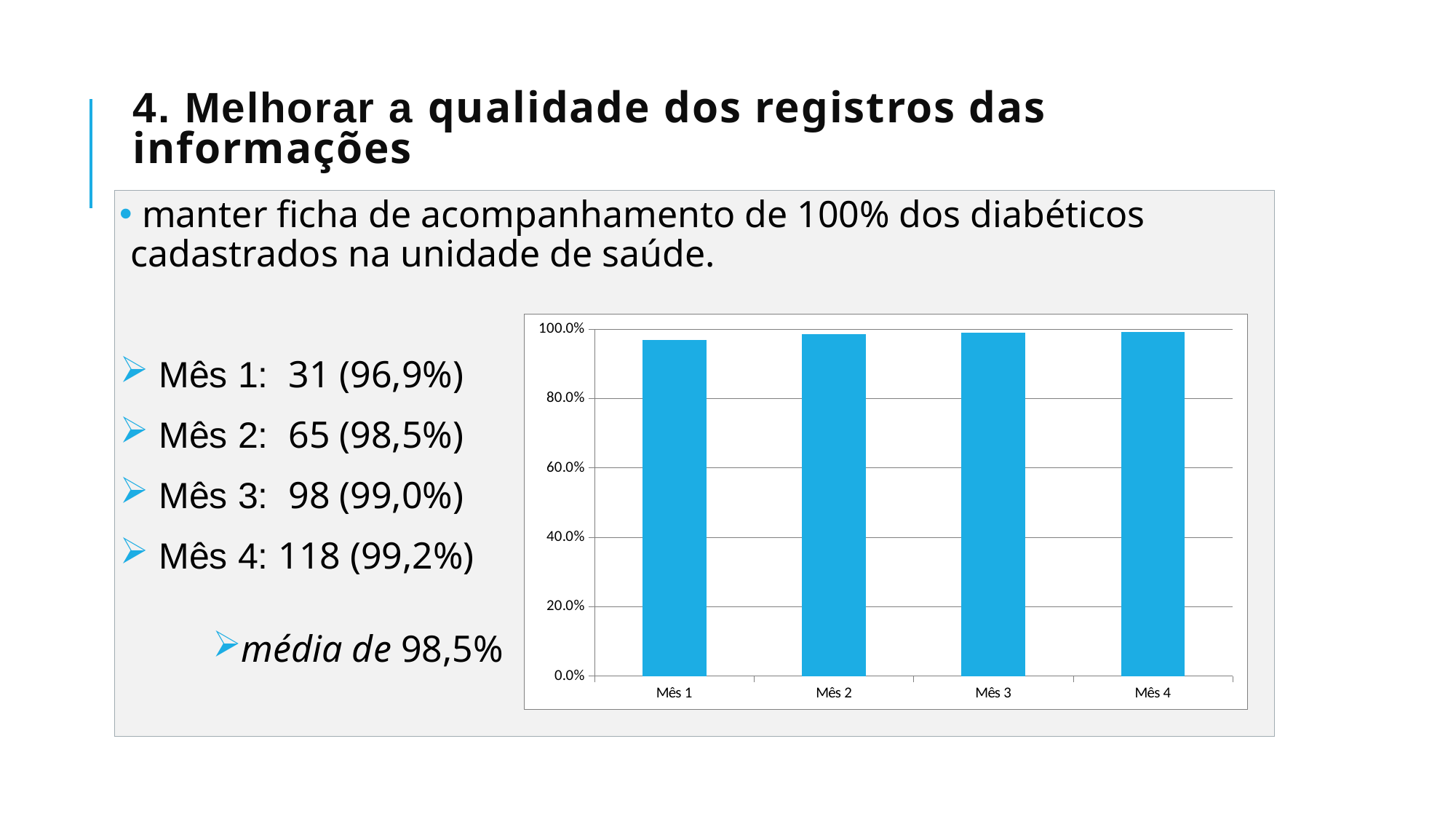
What kind of chart is shown on the slide? bar chart Is the bar for Mês 2 taller or shorter than the bar for Mês 1? taller What is the label of the first category on the x axis? Mês 1 What is the highest value shown on the y axis of the chart? 100.0% Is the value for Mês 1 greater or less than 80.0%? greater According to the slide, what percentage is shown for Mês 1? 96,9% Which month has the lowest bar in the chart? Mês 1 Is the value for Mês 3 greater or less than 60.0%? greater Is the value for Mês 4 greater or less than 100.0%? less According to the slide, what percentage is shown for Mês 4? 99,2% How many categories (months) are plotted on the x axis of the chart? 4 Do the bar values rise or fall from Mês 1 to Mês 4? rise